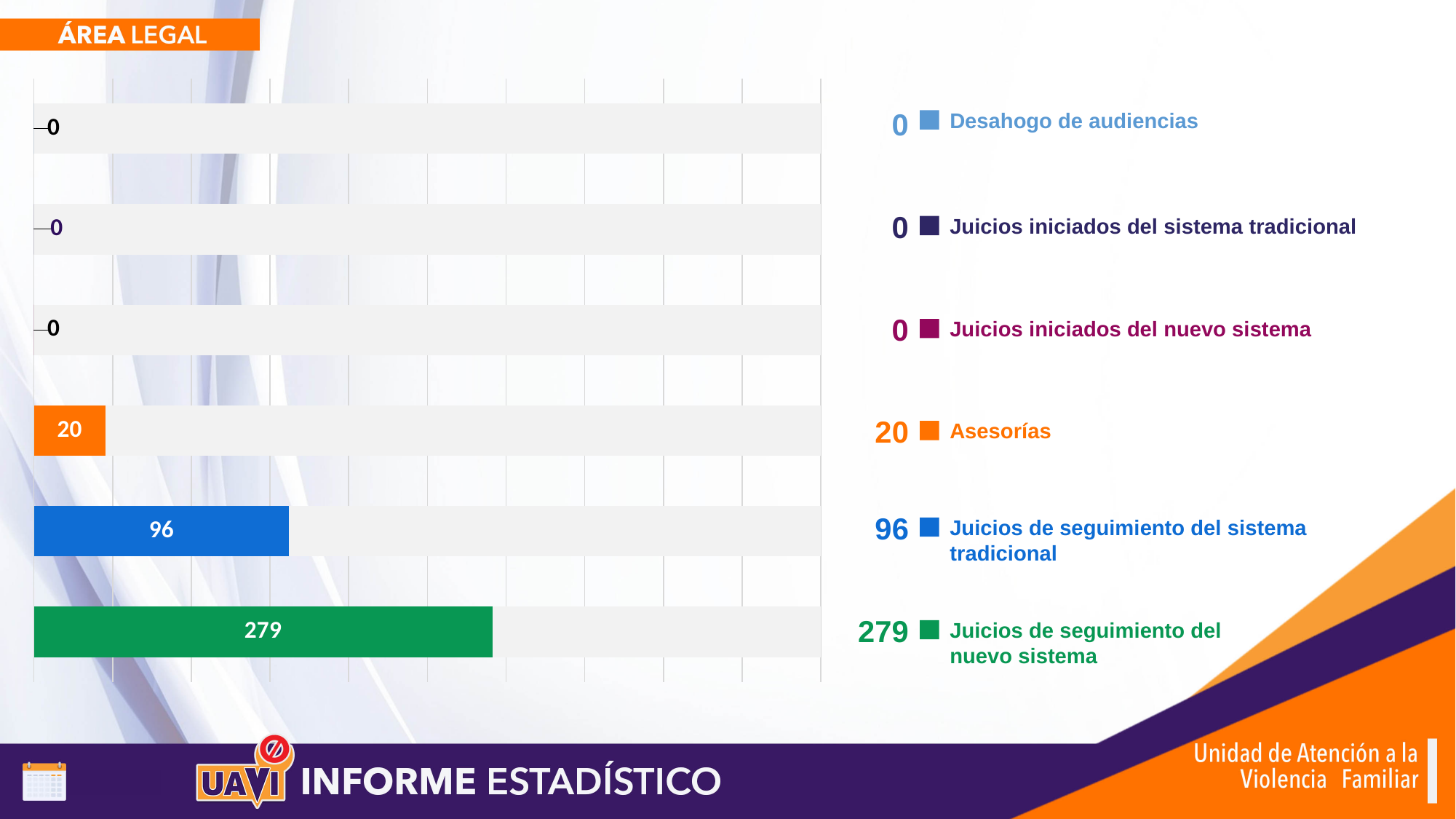
What is the difference between Juicios de seguimiento del nuevo sistema and Juicios de seguimiento del sistema tradicional? 183 What is the difference between Juicios de seguimiento del sistema tradicional and Asesorías? 76 How many categories have a value of 0? 3 What is the value for Juicios de seguimiento del sistema tradicional? 96 What kind of chart is shown on the slide? Bar chart Which is larger, Asesorías or Juicios de seguimiento del sistema tradicional? Juicios de seguimiento del sistema tradicional What colour is the bar for Juicios de seguimiento del nuevo sistema? Green What is the value for Juicios de seguimiento del nuevo sistema? 279 What is the value for Desahogo de audiencias? 0 Which category has the highest value? Juicios de seguimiento del nuevo sistema How many categories are shown in the chart? 6 What is the value for Asesorías? 20